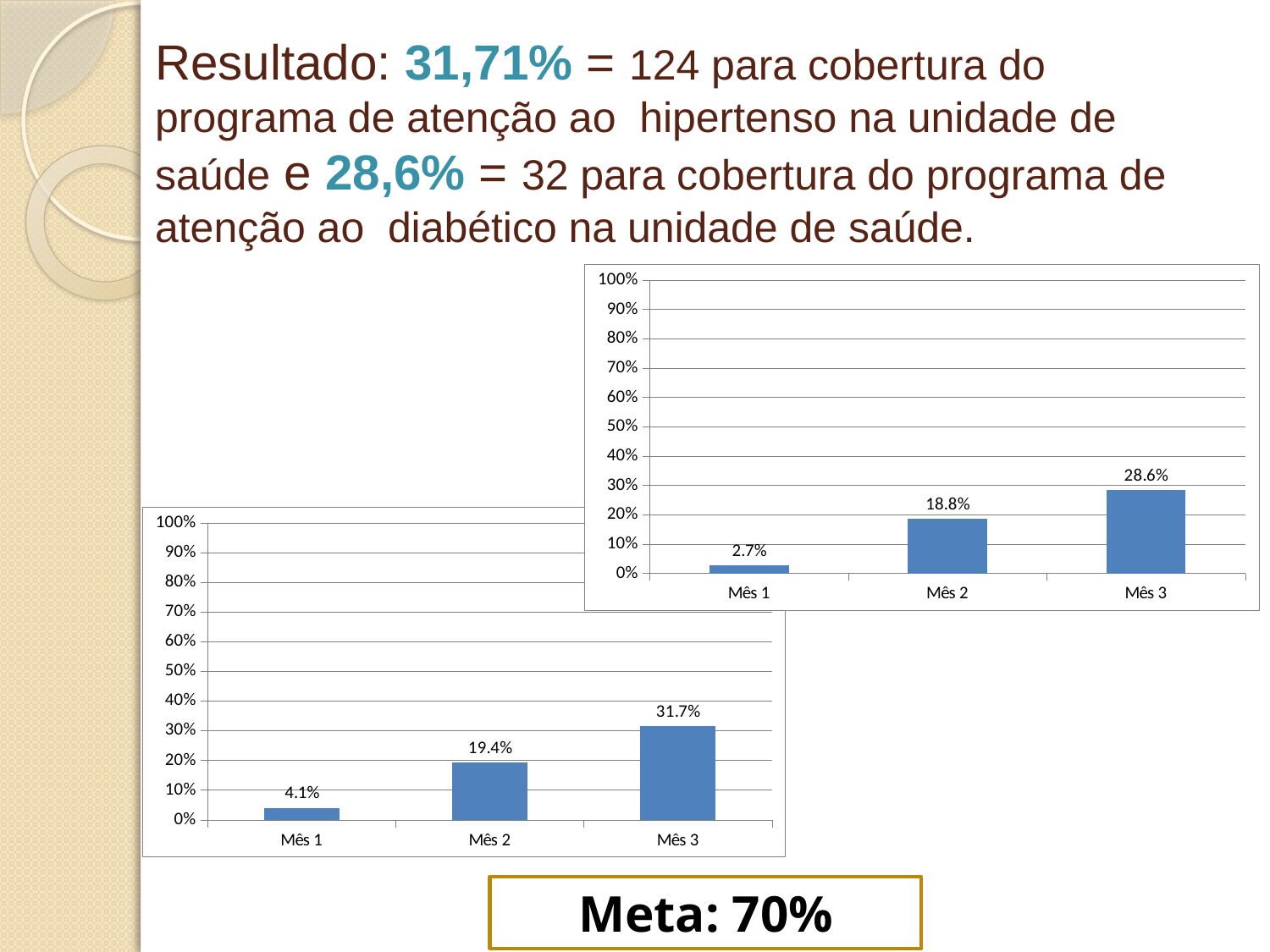
In the upper-right chart, what is the value for Mês 2? 18.8% In the lower-left chart, do the values rise or fall from Mês 1 to Mês 3? rise In the lower-left chart, what is the difference between the values for Mês 3 and Mês 2? 12.3% How many categories are shown on the x axis of the lower-left chart? 3 In the lower-left chart, which month has the lowest value? Mês 1 In the lower-left chart, which is larger, the value for Mês 1 or Mês 2? Mês 2 In the upper-right chart, what is the difference between the values for Mês 2 and Mês 1? 16.1% What kind of chart is the upper-right chart? bar chart In the lower-left chart, what is the value for Mês 3? 31.7% In the upper-right chart, which month has the highest value? Mês 3 In the upper-right chart, is the value for Mês 3 greater or less than 50%? less In the upper-right chart, what is the value for Mês 1? 2.7%